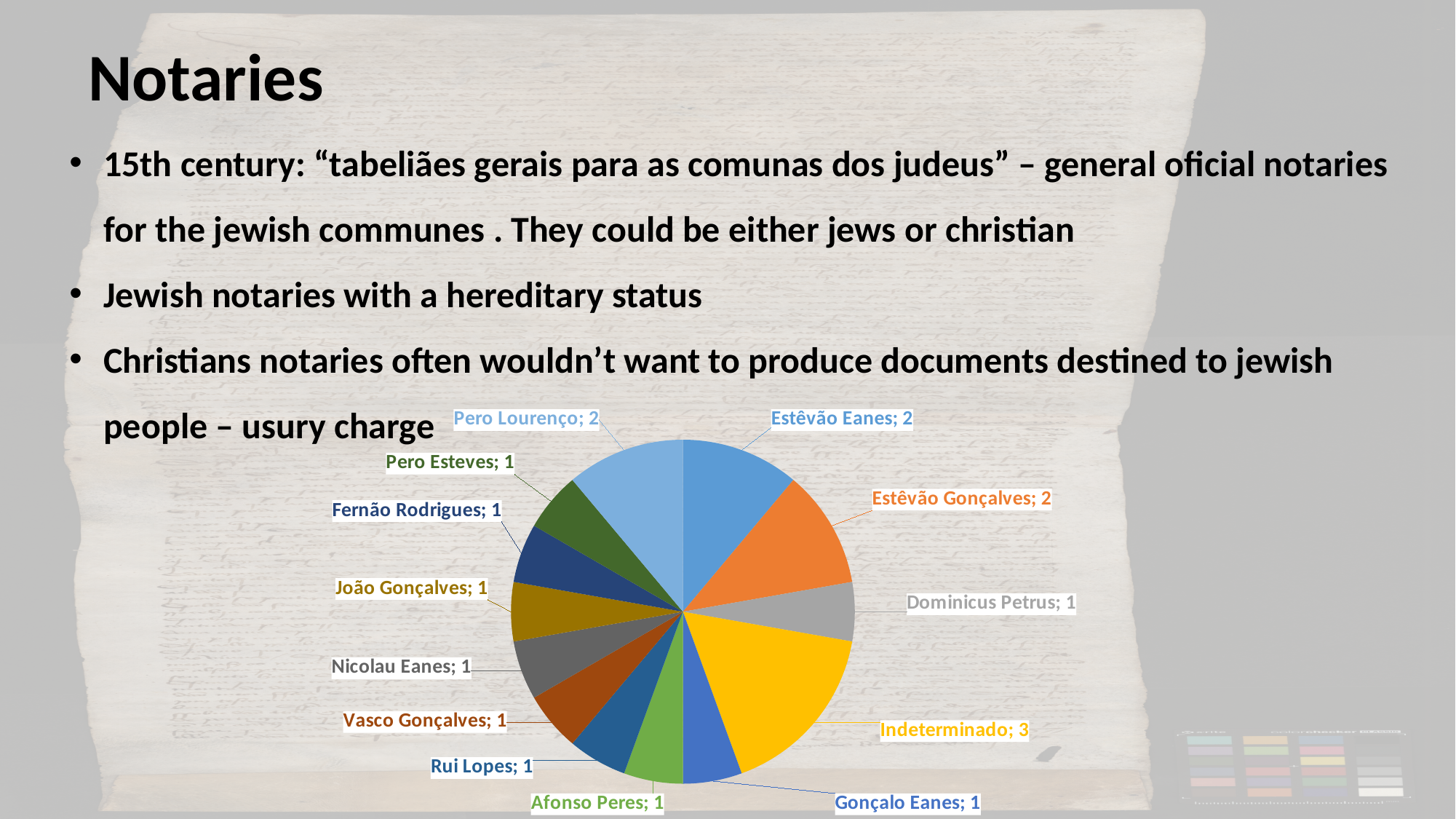
What is the value for Indeterminado in the pie chart? 3 How many categories in the pie chart have a value of 2? 3 What is the value for Fernão Rodrigues in the pie chart? 1 What is the value for Dominicus Petrus in the pie chart? 1 What is the total of all the values shown in the pie chart? 18 What is the value for Pero Lourenço in the pie chart? 2 Which category has the largest slice in the pie chart? Indeterminado How many slices does the pie chart have? 13 Which is larger in the pie chart, Pero Lourenço or Pero Esteves? Pero Lourenço What is the value for Estêvão Gonçalves in the pie chart? 2 What kind of chart is shown on the slide? pie chart What is the difference between the values for Indeterminado and Estêvão Eanes? 1